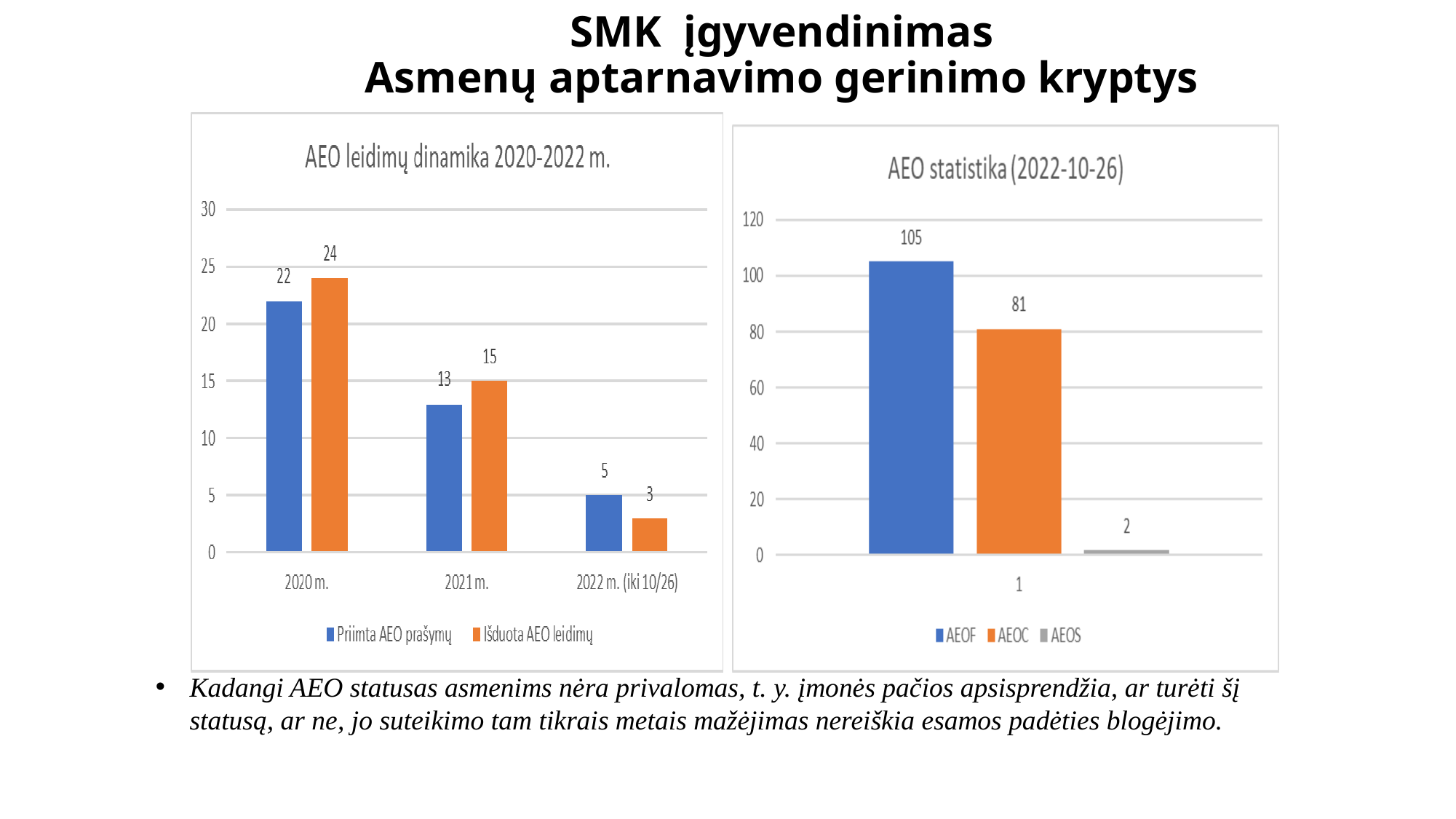
What type of chart is 'AEO statistika (2022-10-26)'? bar chart In the chart 'AEO statistika (2022-10-26)', what is the value for AEOF? 105 In the chart 'AEO leidimų dinamika 2020-2022 m.', what is the value of 'Išduota AEO leidimų' for 2021 m.? 15 In the chart 'AEO statistika (2022-10-26)', which series has the lowest value? AEOS In the chart 'AEO statistika (2022-10-26)', how many series does the legend list? 3 In the chart 'AEO leidimų dinamika 2020-2022 m.', what is the value of 'Priimta AEO prašymų' for 2020 m.? 22 In the chart 'AEO statistika (2022-10-26)', what is the difference between AEOF and AEOC? 24 In the chart 'AEO leidimų dinamika 2020-2022 m.', what is the difference between 'Išduota AEO leidimų' and 'Priimta AEO prašymų' in 2020 m.? 2 In the chart 'AEO leidimų dinamika 2020-2022 m.', which year has the highest value for 'Išduota AEO leidimų'? 2020 m. In the chart 'AEO leidimų dinamika 2020-2022 m.', which is larger in 2022 m. (iki 10/26): 'Priimta AEO prašymų' or 'Išduota AEO leidimų'? Priimta AEO prašymų In the chart 'AEO leidimų dinamika 2020-2022 m.', how many series does the legend list? 2 In the chart 'AEO leidimų dinamika 2020-2022 m.', does 'Priimta AEO prašymų' rise or fall from 2020 m. to 2022 m. (iki 10/26)? fall